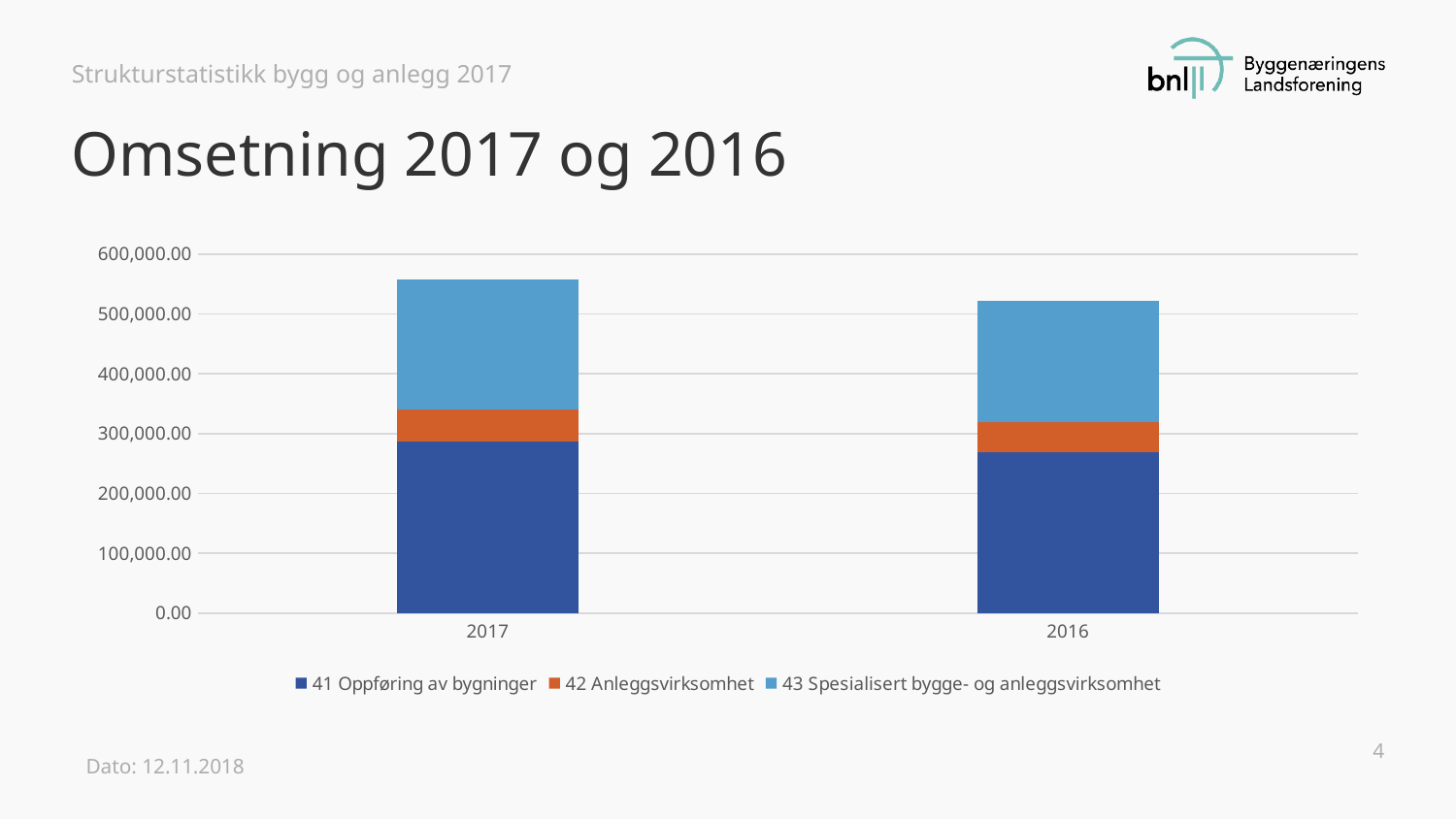
Which year has the taller stacked bar, 2017 or 2016? 2017 How many categories are shown on the x axis of the chart? 2 Which year has the highest total stacked bar? 2017 Do the total stacked bar values rise or fall moving from 2017 to 2016 along the x axis? fall What kind of chart is shown on the slide? Stacked bar chart How many series does the chart legend list? 3 Which legend entry is shown in orange? 42 Anleggsvirksomhet Is the total of the stacked bar for 2017 greater or less than 500,000.00? greater Which year has the lowest total stacked bar? 2016 Is the value for 41 Oppføring av bygninger in 2016 greater or less than 300,000.00? less What is the title of the slide containing the chart? Omsetning 2017 og 2016 Is the value for 41 Oppføring av bygninger in 2017 greater or less than 200,000.00? greater